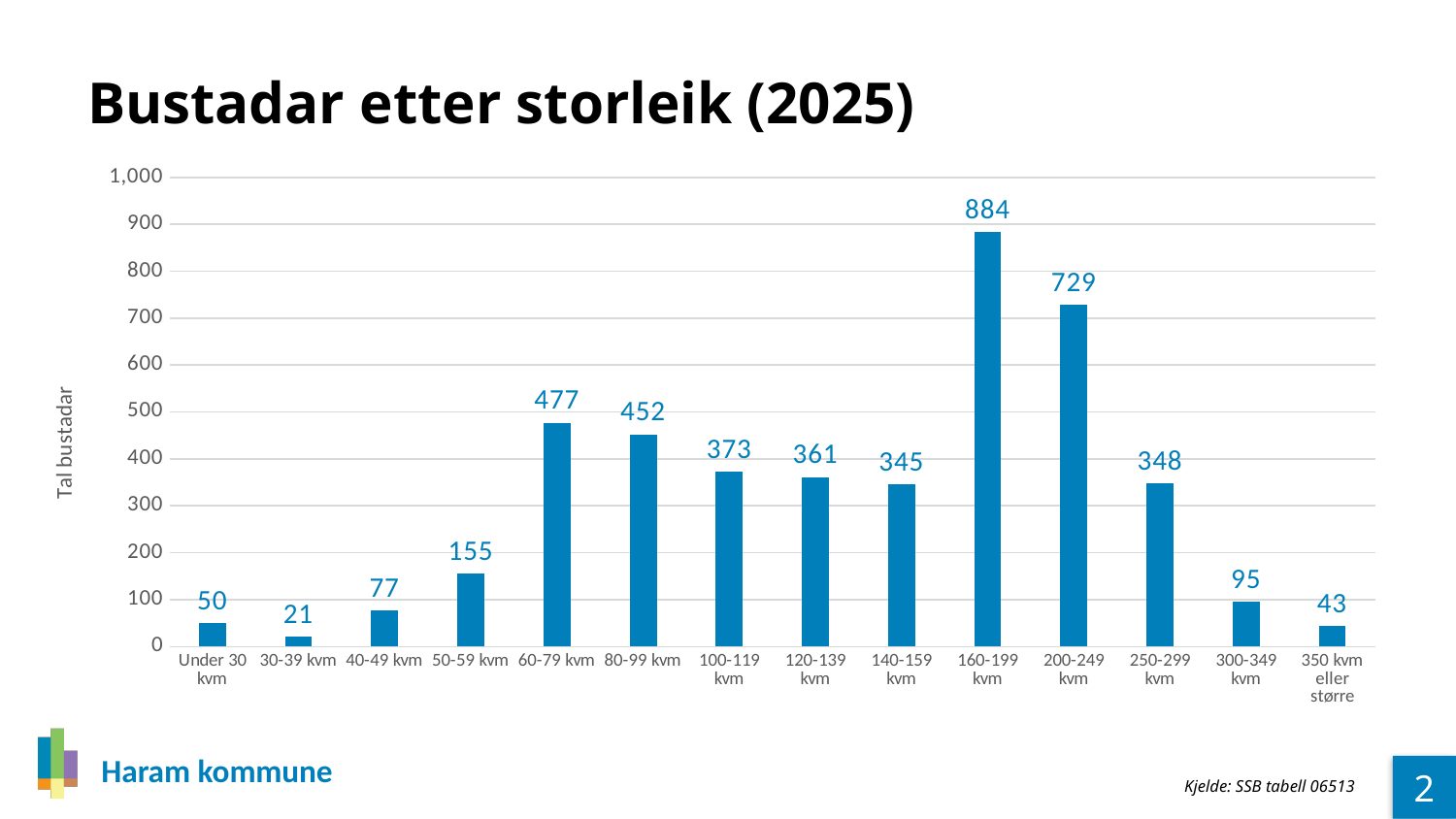
Which category has the highest value? 160-199 kvm What is the value for 350 kvm eller større? 43 What is the title of the chart? Bustadar etter storleik (2025) Which category has the lowest value? 30-39 kvm Which is larger, the value for 100-119 kvm or the value for 250-299 kvm? 100-119 kvm What is the difference between the values for 160-199 kvm and 200-249 kvm? 155 How many categories are shown on the x axis? 14 Is the value for 200-249 kvm greater or less than 700? greater What is the difference between the values for 60-79 kvm and 80-99 kvm? 25 What is the value for 50-59 kvm? 155 What kind of chart is shown on the slide? bar chart What is the value for 160-199 kvm? 884